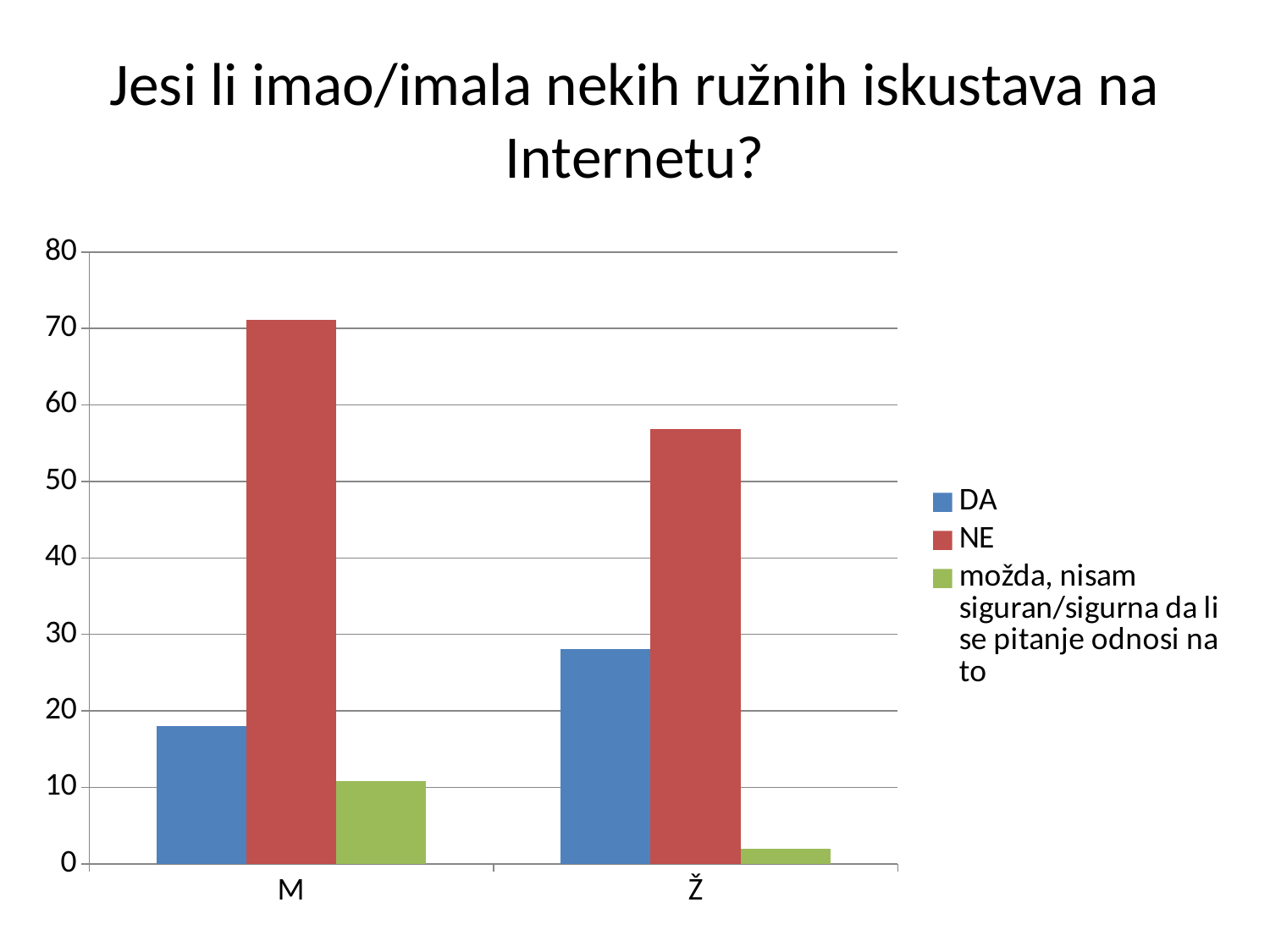
Which series has the highest value for category M? NE How many series does the legend list? 3 Is the DA value for Ž greater or less than 20? greater Is the NE value for Ž greater or less than 50? greater Which category has the larger DA value, M or Ž? Ž Is the DA value for M greater or less than 20? less Which category has the larger NE value, M or Ž? M How many categories are shown on the x axis? 2 Which series has the lowest value for category Ž? možda, nisam siguran/sigurna da li se pitanje odnosi na to What kind of chart is shown on the slide? bar chart